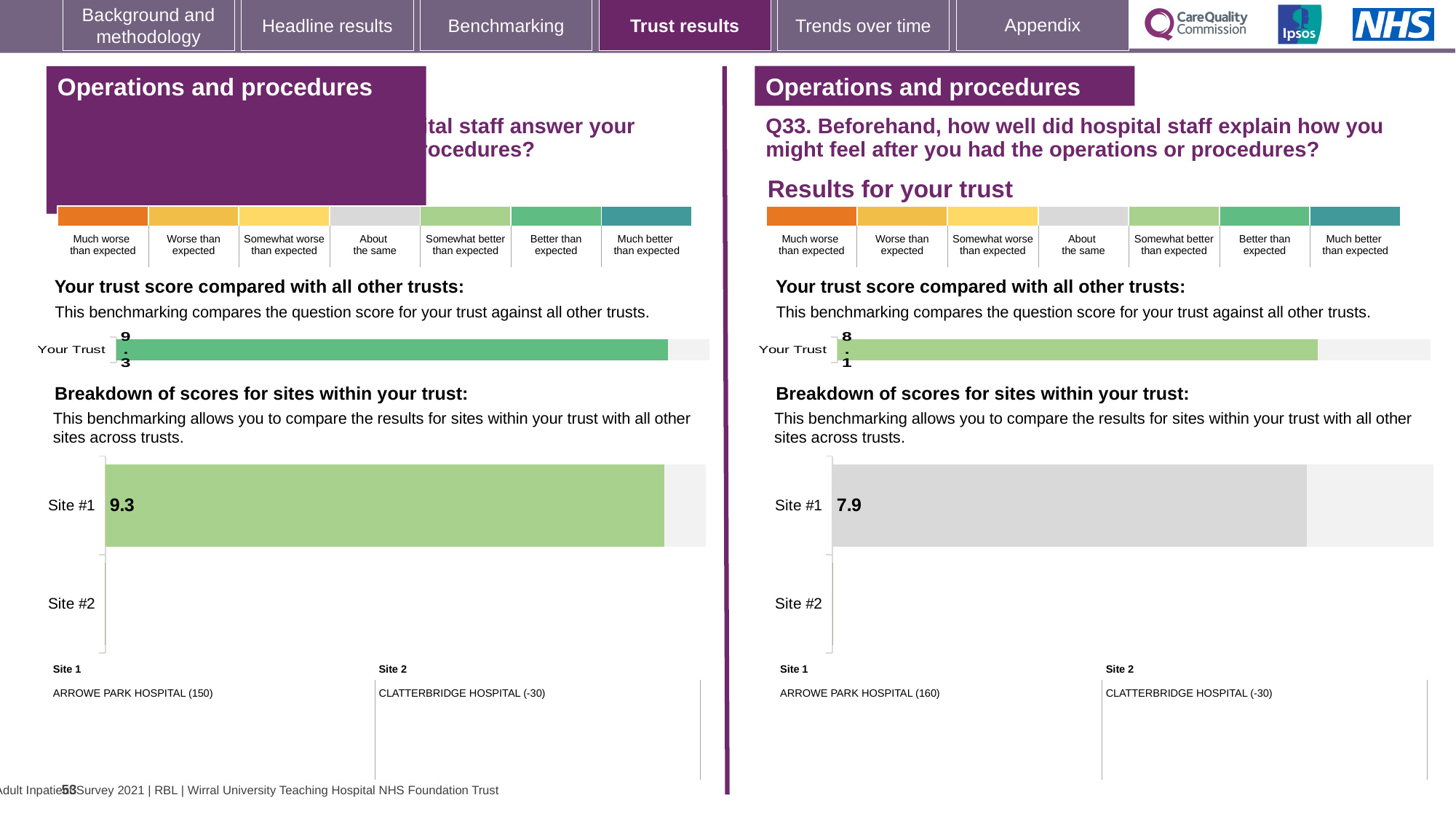
What is the difference between the Your Trust score on the left half (9.3) and the Your Trust score on the right half (8.1)? 1.2 In the right (Q33) 'Breakdown of scores for sites within your trust' chart, what is the score for Site #1? 7.9 Which is larger: the Your Trust score on the left half of the slide or the Your Trust score on the right half (Q33)? Left (9.3) What type of chart is used to show the Your Trust score on the right half of the slide? Bar chart On the right half of the slide (Q33), what is the score shown for Your Trust in the 'Your trust score compared with all other trusts' chart? 8.1 In the left 'Breakdown of scores for sites within your trust' chart, what is the score for Site #1? 9.3 Which hospital is listed as Site 1 under the right (Q33) breakdown chart? ARROWE PARK HOSPITAL (160) On the left half of the slide, what is the score shown for Your Trust in the 'Your trust score compared with all other trusts' chart? 9.3 In the right (Q33) breakdown chart, which site has a bar plotted? Site #1 How many sites are listed in the right (Q33) 'Breakdown of scores for sites within your trust' chart? 2 What is the difference between the Site #1 score in the left breakdown chart (9.3) and the Site #1 score in the right (Q33) breakdown chart (7.9)? 1.4 Which is larger: the Site #1 score in the left breakdown chart or the Site #1 score in the right (Q33) breakdown chart? Left (9.3)